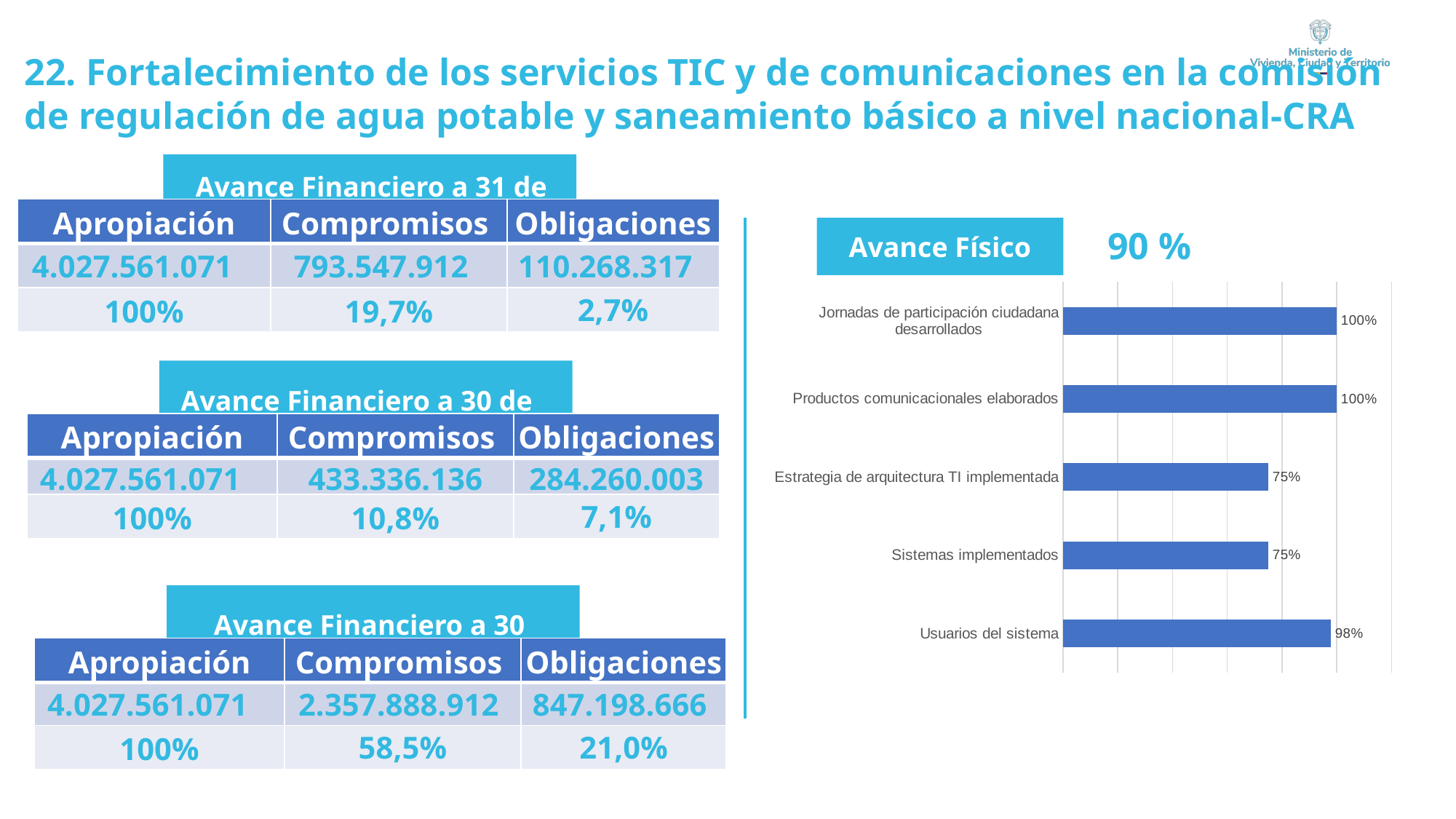
What is the value for Productos comunicacionales elaborados? 100% What is the value for Estrategia de arquitectura TI implementada? 75% What is the value for Jornadas de participación ciudadana desarrollados? 100% What is the title of the bar chart? Avance Físico What is the difference between the value for Productos comunicacionales elaborados and the value for Usuarios del sistema? 2% What is the difference between the value for Usuarios del sistema and the value for Sistemas implementados? 23% What is the value for Usuarios del sistema? 98% Which category has the lowest value in the bar chart? Estrategia de arquitectura TI implementada and Sistemas implementados Which is larger, the value for Usuarios del sistema or the value for Estrategia de arquitectura TI implementada? Usuarios del sistema How many categories does the bar chart show? 5 What kind of chart is shown on the slide? bar chart What is the value for Sistemas implementados? 75%